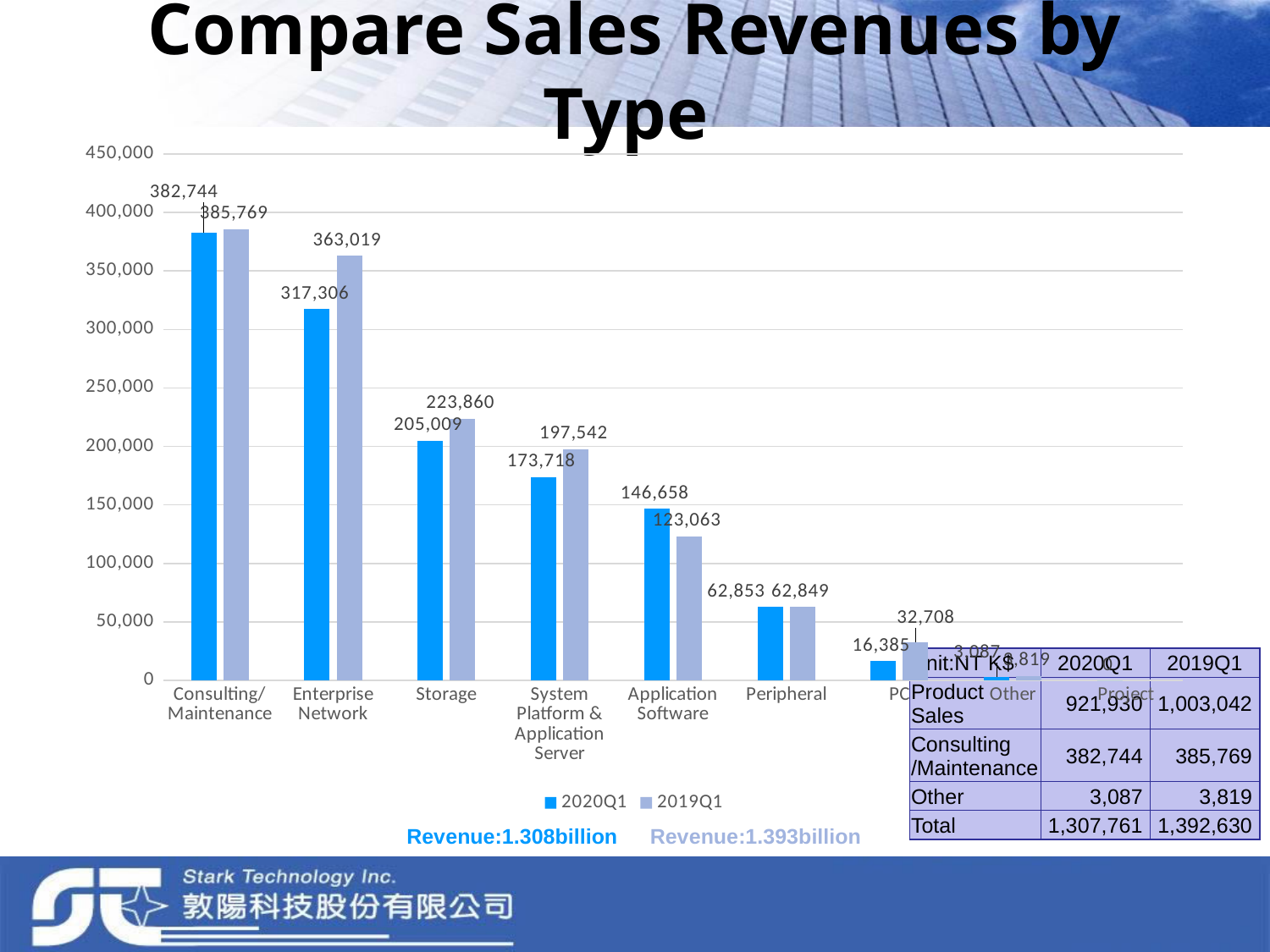
What is the difference between the 2019Q1 and 2020Q1 values for System Platform & Application Server? 23,824 How many series does the legend list? 2 Do the 2020Q1 values generally rise or fall from left to right across the categories? fall Which category has the highest 2020Q1 value? Consulting/Maintenance What is the 2020Q1 value for Storage? 205,009 What is the 2019Q1 value for PC? 32,708 For Application Software, which is larger: the 2020Q1 value or the 2019Q1 value? 2020Q1 What is the 2020Q1 value for Application Software? 146,658 What is the 2019Q1 value for Enterprise Network? 363,019 What is the difference between the 2019Q1 and 2020Q1 values for Enterprise Network? 45,713 What kind of chart is shown on the slide? bar chart Is the 2019Q1 value for Storage greater or less than 200,000? greater